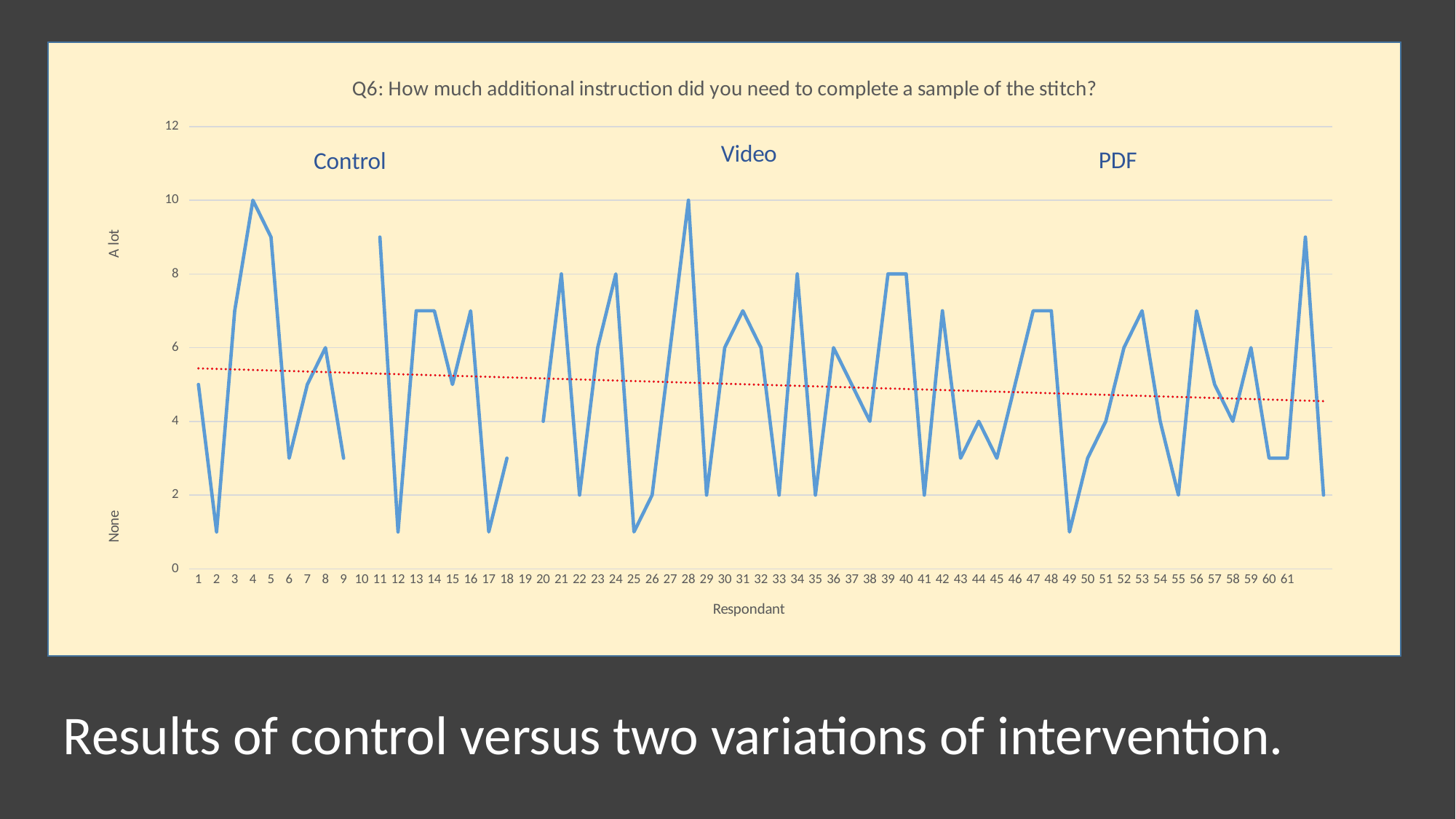
Does the dotted trend line rise or fall from left to right across the respondents? fall Is the value for respondent 2 greater or less than 2? less What is the value for respondent 4? 10 What is the title of the chart? Q6: How much additional instruction did you need to complete a sample of the stitch? What is the value for respondent 28? 10 Is the value for respondent 49 greater or less than 2? less What kind of chart is shown on the slide? line chart What is the value for respondent 21? 8 What are the three group labels written above the plotted line? Control, Video, PDF How many respondents are shown on the x axis? 61 What is the value for respondent 61? 3 Is the value for respondent 11 greater or less than 8? greater